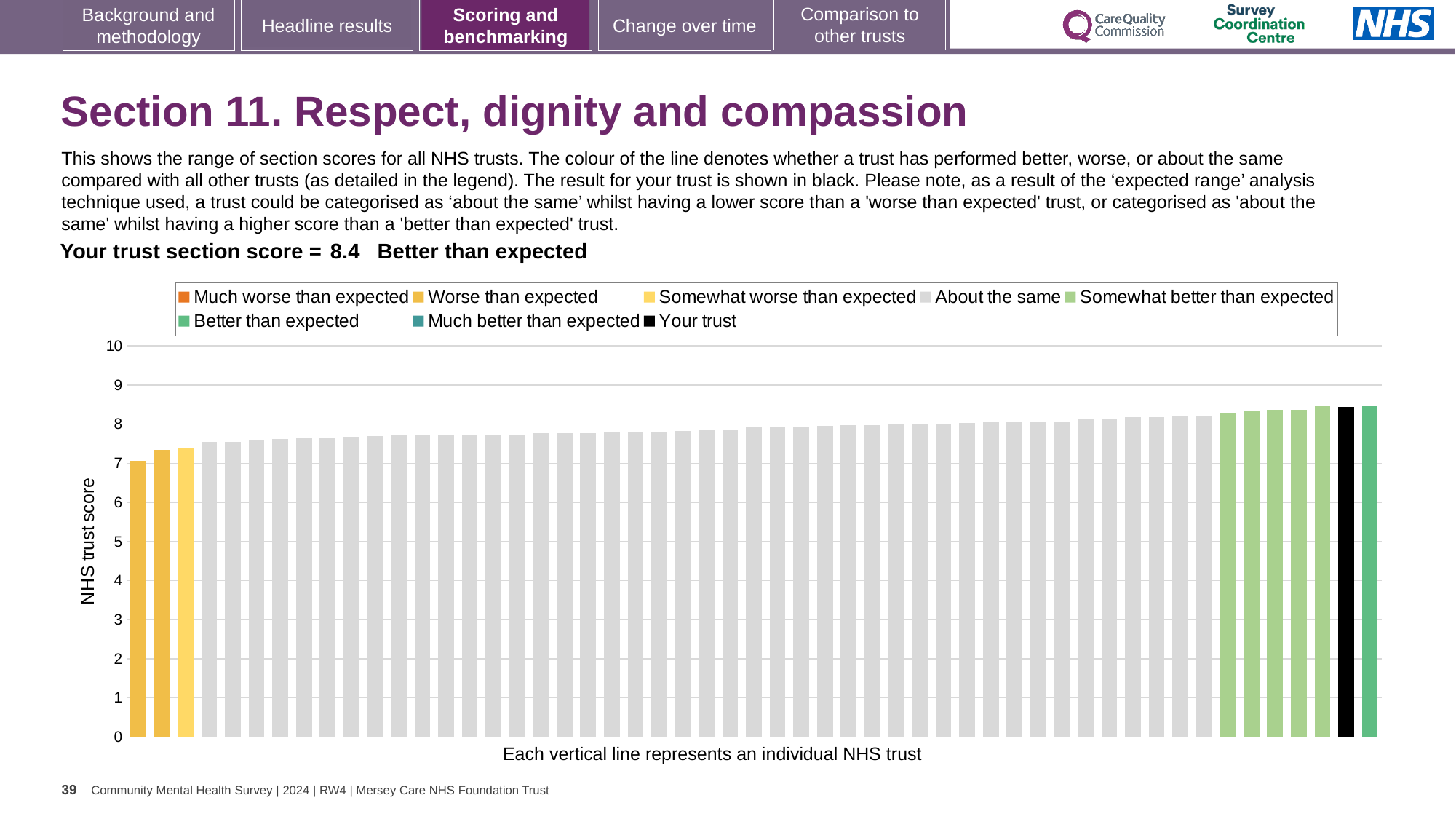
Is the value of the black 'Your trust' bar greater or less than 8? greater Is the value of the rightmost bar greater or less than 8? greater What is the label on the vertical axis of the chart? NHS trust score How many bars are coloured as 'Somewhat better than expected' (light green)? 5 What is the maximum value shown on the vertical axis? 10 Is the value of the leftmost (lowest) bar greater or less than 8? less What colour is the bar representing your trust? black Which performance category is your trust's section score assigned to? Better than expected What type of chart is shown on the slide? bar chart Do the bar values rise or fall from left to right along the x axis? rise What is the section score for your trust shown on the slide? 8.4 How many entries does the chart legend list? 8